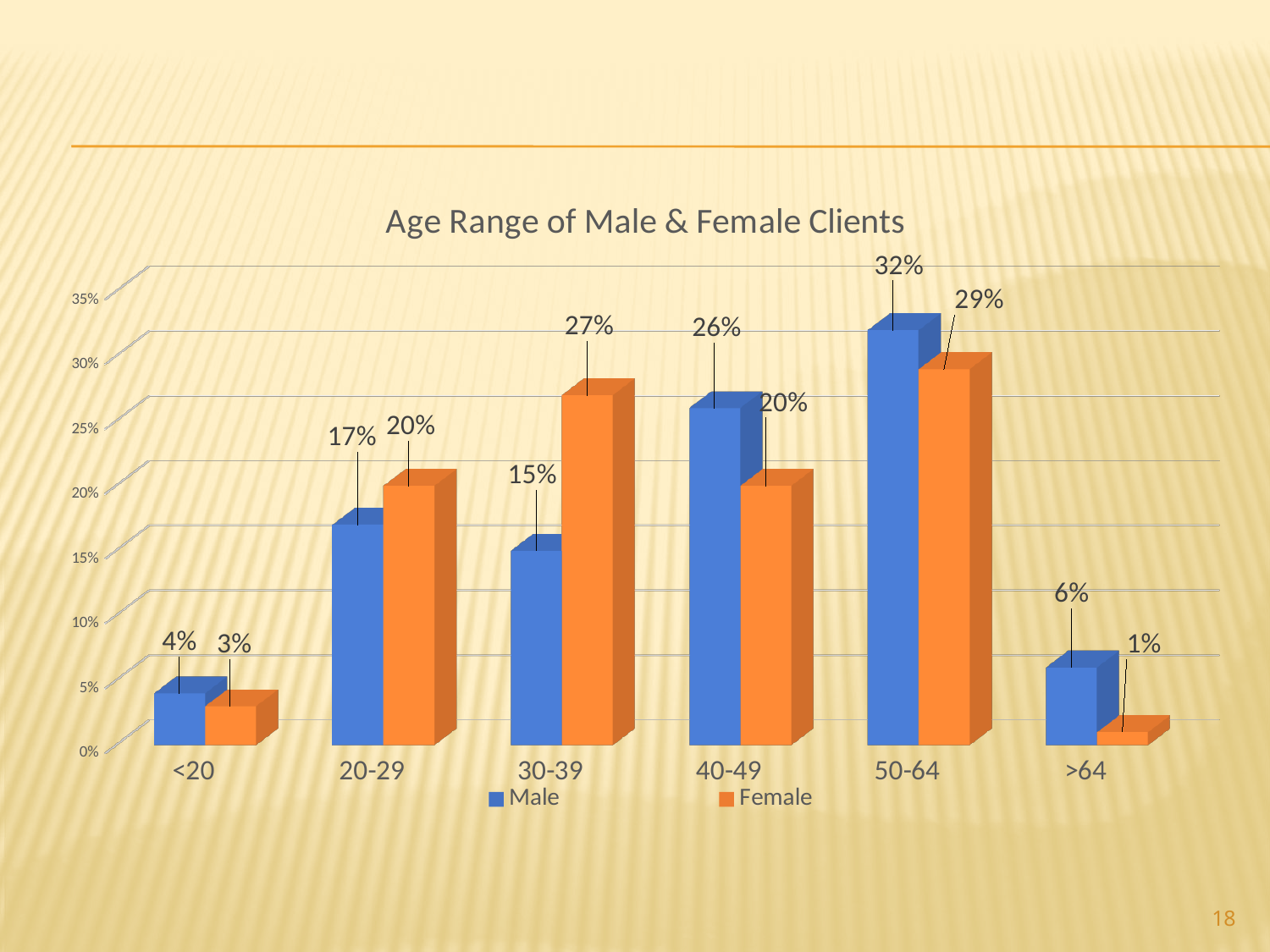
What is the Female value for the 30-39 age range? 27% What is the title of the chart? Age Range of Male & Female Clients What is the Female value for the >64 age range? 1% Which is larger for the 40-49 age range, the Male value or the Female value? Male How many age ranges are shown on the x axis? 6 Which age range has the lowest Female value? >64 How many series does the legend list? 2 What kind of chart is shown on the slide? Bar chart Which age range has the highest Male value? 50-64 What is the difference between the Female and Male values for the 30-39 age range? 12% Which colour represents the Female series? Orange What is the Male value for the 50-64 age range? 32%